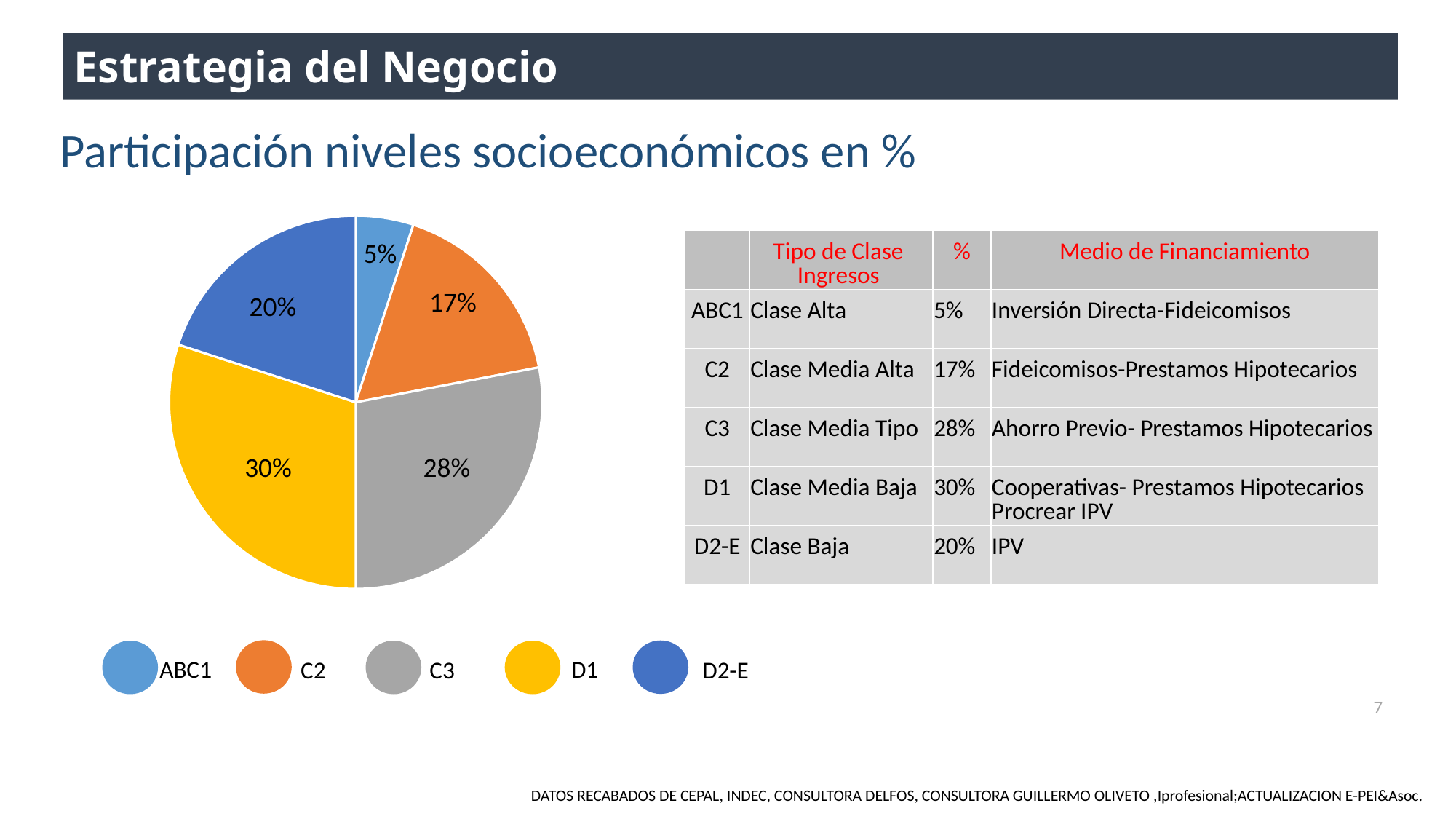
Which category has the smallest slice in the pie chart? ABC1 Which category has the largest slice in the pie chart? D1 What is the difference between the D1 and C3 slices in the pie chart? 2% What is the value for the C2 slice in the pie chart? 17% What is the difference between the D2-E and ABC1 slices in the pie chart? 15% What type of chart is shown on the slide? pie chart What is the value for the D2-E slice in the pie chart? 20% What colour is the D1 slice in the pie chart? yellow What share of the pie does the C3 slice represent? 28% How many slices does the pie chart have? 5 What is the value for the ABC1 slice in the pie chart? 5% Which is larger in the pie chart, C2 or D2-E? D2-E